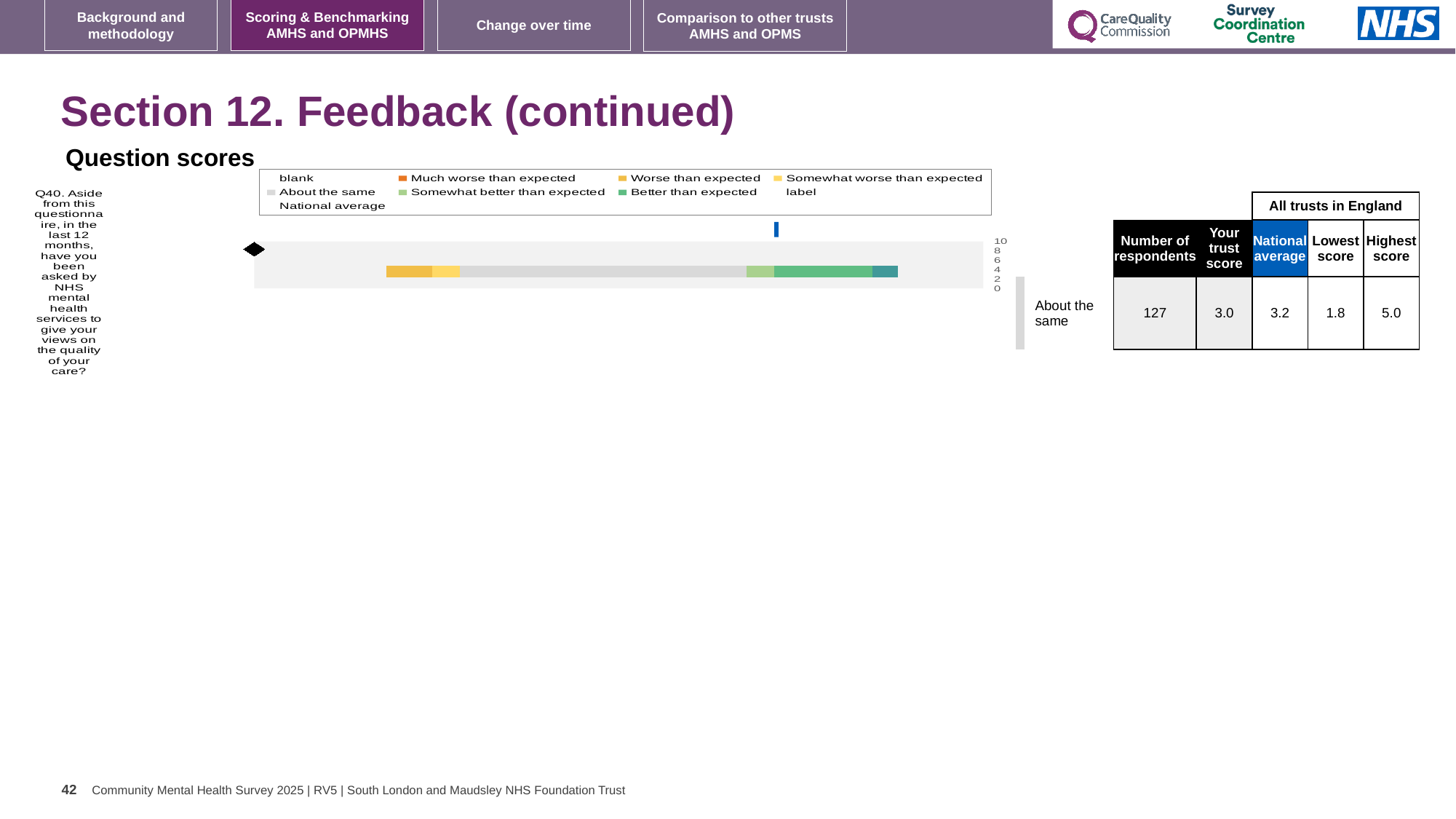
What kind of chart is used to show the Q40 question score? bar chart In the table beside the chart, what is the trust's score for Q40? 3.0 In the table beside the chart, what is the highest score among all trusts in England for Q40? 5.0 In the table beside the chart, what is the lowest score among all trusts in England for Q40? 1.8 According to the label next to the chart, which band does the trust's Q40 score fall into? About the same Which legend entry in the Question scores chart is shown in orange? Much worse than expected Which legend entry in the Question scores chart is shown in light grey? About the same In the table beside the chart, what is the national average score for Q40? 3.2 How many questions (categories) are plotted in the Question scores chart? 1 How many entries does the legend of the Question scores chart list? 9 Which is larger for Q40: the trust's score or the national average? national average In the table beside the chart, what is the number of respondents for Q40? 127